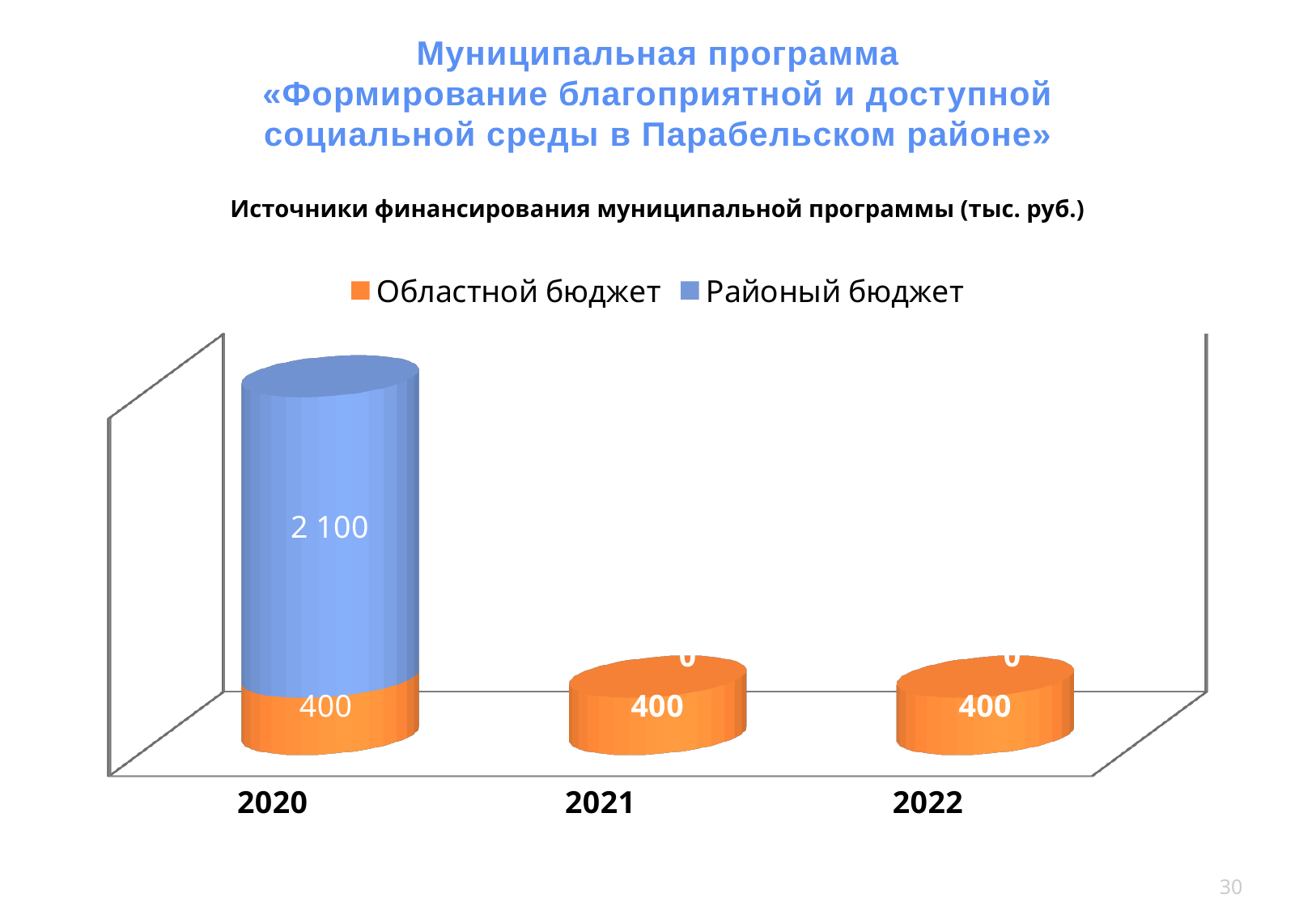
What is the value for Областной бюджет in 2020? 400 What is the value for Областной бюджет in 2021? 400 What is the value for Районый бюджет in 2022? 0 What kind of chart is shown on the slide? Stacked bar chart What is the value for Районый бюджет in 2020? 2 100 Which year has the highest value for Районый бюджет? 2020 What is the difference between Районый бюджет and Областной бюджет in 2020? 1 700 What is the total of the stacked bar for 2020? 2 500 Which is larger in 2020: Областной бюджет or Районый бюджет? Районый бюджет How many series does the legend list? 2 What is the total of the stacked bar for 2021? 400 How many years are shown on the x axis? 3